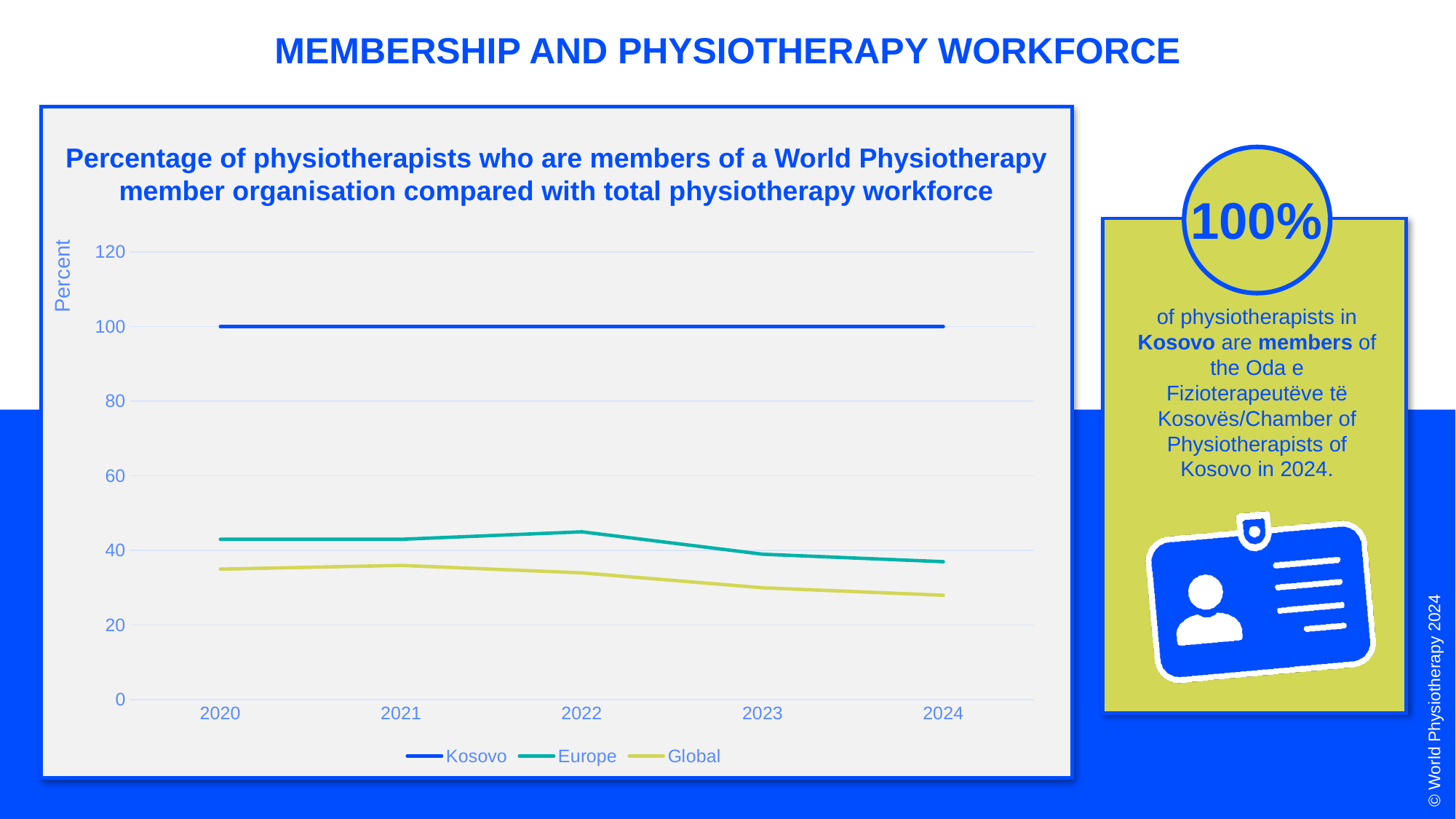
What kind of chart is shown on the slide? line chart Is the value for Global in 2024 greater or less than 30? less What is the label on the y axis of the chart? Percent What is the value for Kosovo in 2024? 100 Which series has the highest values across all years? Kosovo How many years are shown on the x axis of the chart? 5 Does the Global line rise or fall between 2021 and 2024? fall What is the value for Kosovo in 2020? 100 How many series does the chart legend list? 3 Which series has the lowest values across all years? Global Is the value for Europe in 2022 greater or less than 40? greater Which is larger in 2023, the value for Europe or the value for Global? Europe